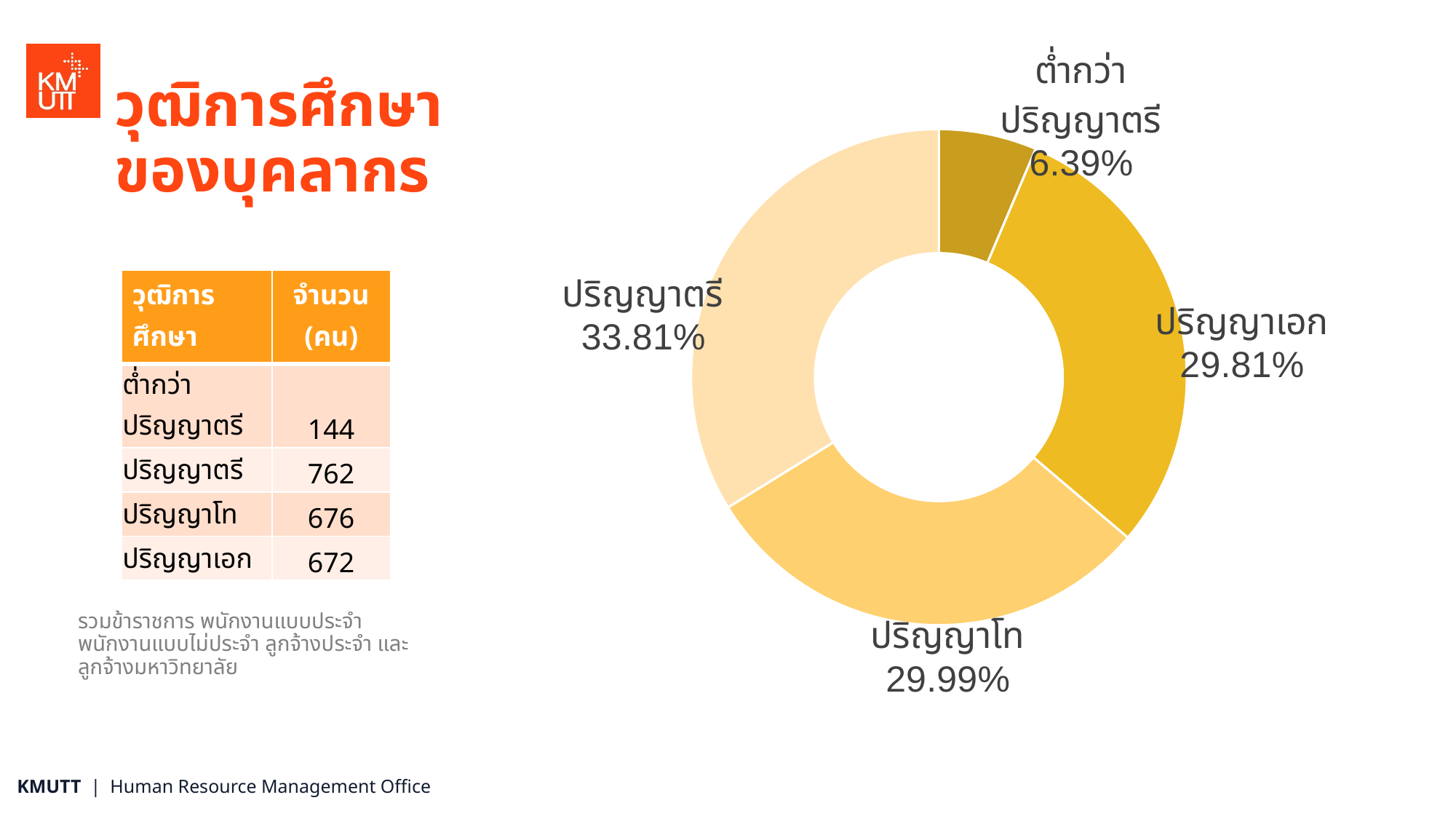
What is the difference in percentage points between ปริญญาตรี and ต่ำกว่าปริญญาตรี on the donut chart? 27.42% What is the difference in percentage points between ปริญญาตรี and ปริญญาโท on the donut chart? 3.82% What percentage is shown for ต่ำกว่าปริญญาตรี on the donut chart? 6.39% What kind of chart is shown on the slide? Donut (pie) chart What share of the donut chart is labelled ปริญญาตรี? 33.81% Which category has the largest share in the donut chart? ปริญญาตรี Which category has the smallest share in the donut chart? ต่ำกว่าปริญญาตรี Which has the larger share on the donut chart, ปริญญาตรี or ปริญญาเอก? ปริญญาตรี What percentage is shown for ปริญญาเอก on the donut chart? 29.81% What is the title of the slide containing the donut chart? วุฒิการศึกษาของบุคลากร What percentage is shown for ปริญญาโท on the donut chart? 29.99% How many slices does the donut chart have? 4